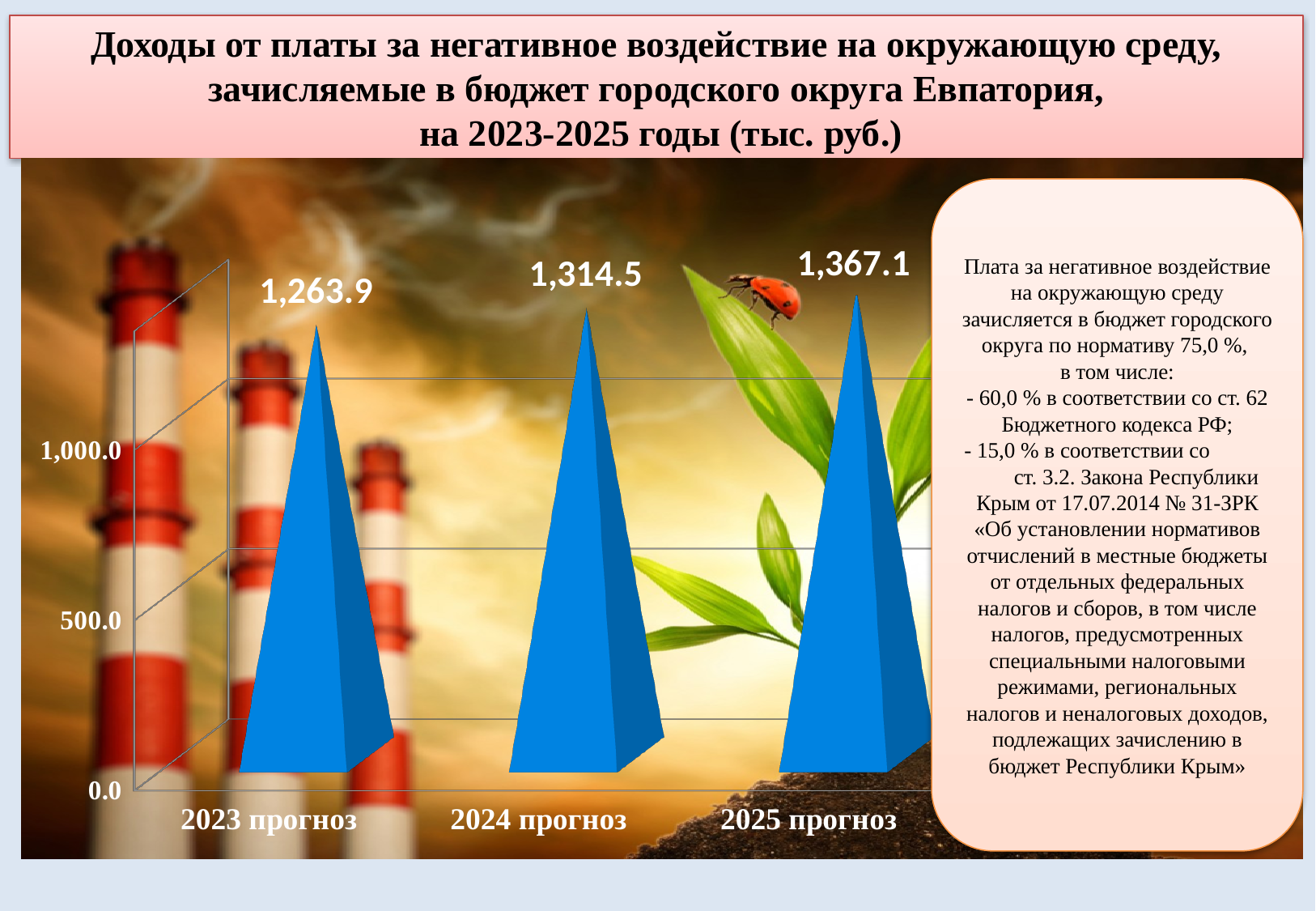
What is the value for 2024 прогноз? 1,314.5 How many categories are shown on the x axis? 3 Which year has the highest value? 2025 прогноз Is the value for 2023 прогноз greater or less than 1,000.0? greater Do the values rise or fall from 2023 прогноз to 2025 прогноз? rise What kind of chart is shown on the slide? bar chart What is the difference between the values for 2024 прогноз and 2023 прогноз? 50.6 What is the difference between the values for 2025 прогноз and 2023 прогноз? 103.2 What is the value for 2023 прогноз? 1,263.9 What is the value for 2025 прогноз? 1,367.1 Which year has the lowest value? 2023 прогноз Which is larger, the value for 2024 прогноз or 2025 прогноз? 2025 прогноз